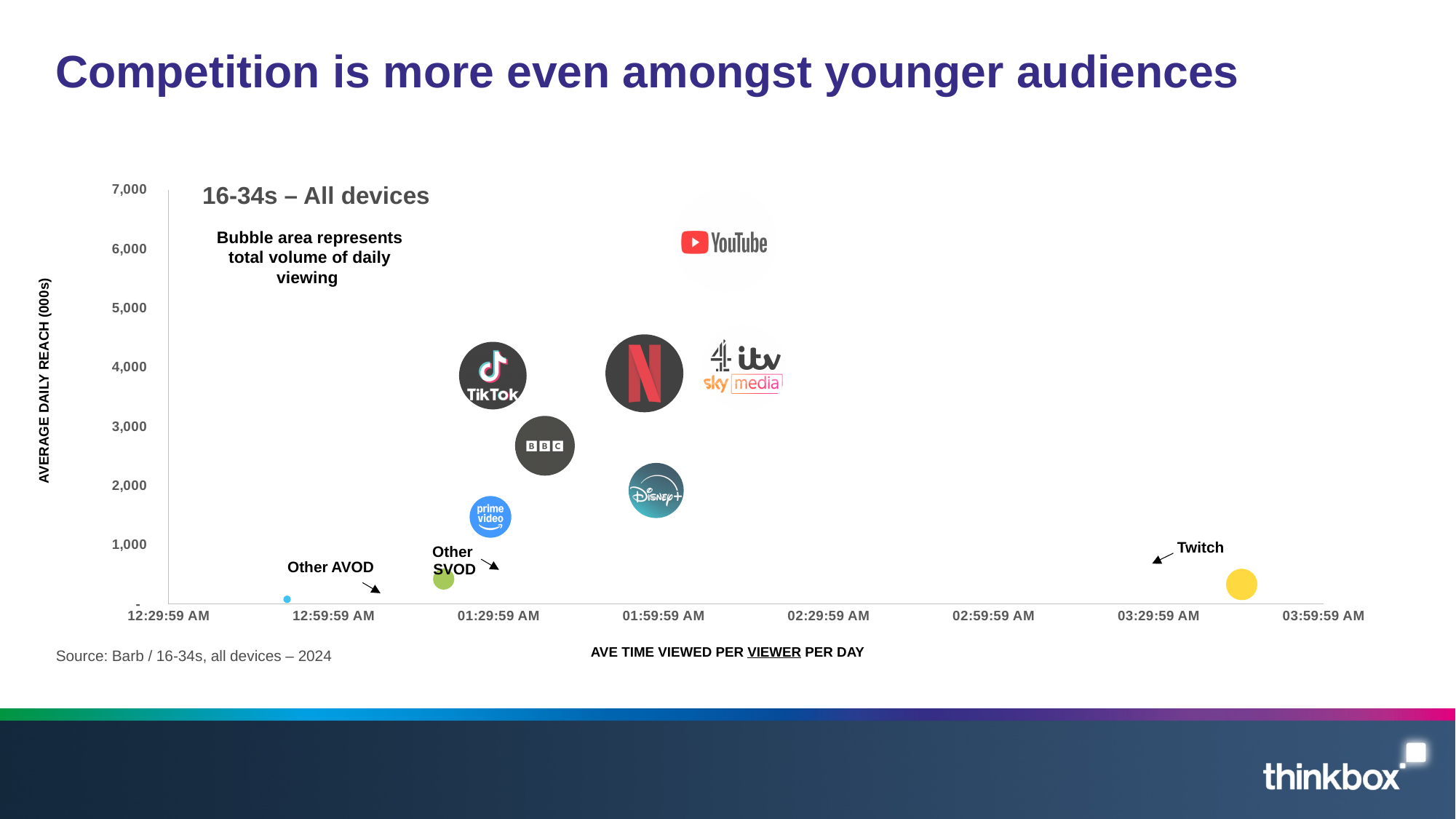
What is the title of the chart? 16-34s – All devices Is the average daily reach for Twitch greater or less than 1,000? less Which has the higher average daily reach, YouTube or Netflix? YouTube Is the average daily reach for YouTube greater or less than 5,000? greater Which platform has the highest average time viewed per viewer per day? Twitch Which platform has the highest average daily reach? YouTube Is the average daily reach for BBC greater or less than 2,000? greater Which has the higher average time viewed per viewer per day, Twitch or Prime Video? Twitch Which platform has the lowest average daily reach? Other AVOD According to the chart's note, what does the bubble area represent? Total volume of daily viewing What kind of chart is shown on the slide? Bubble chart